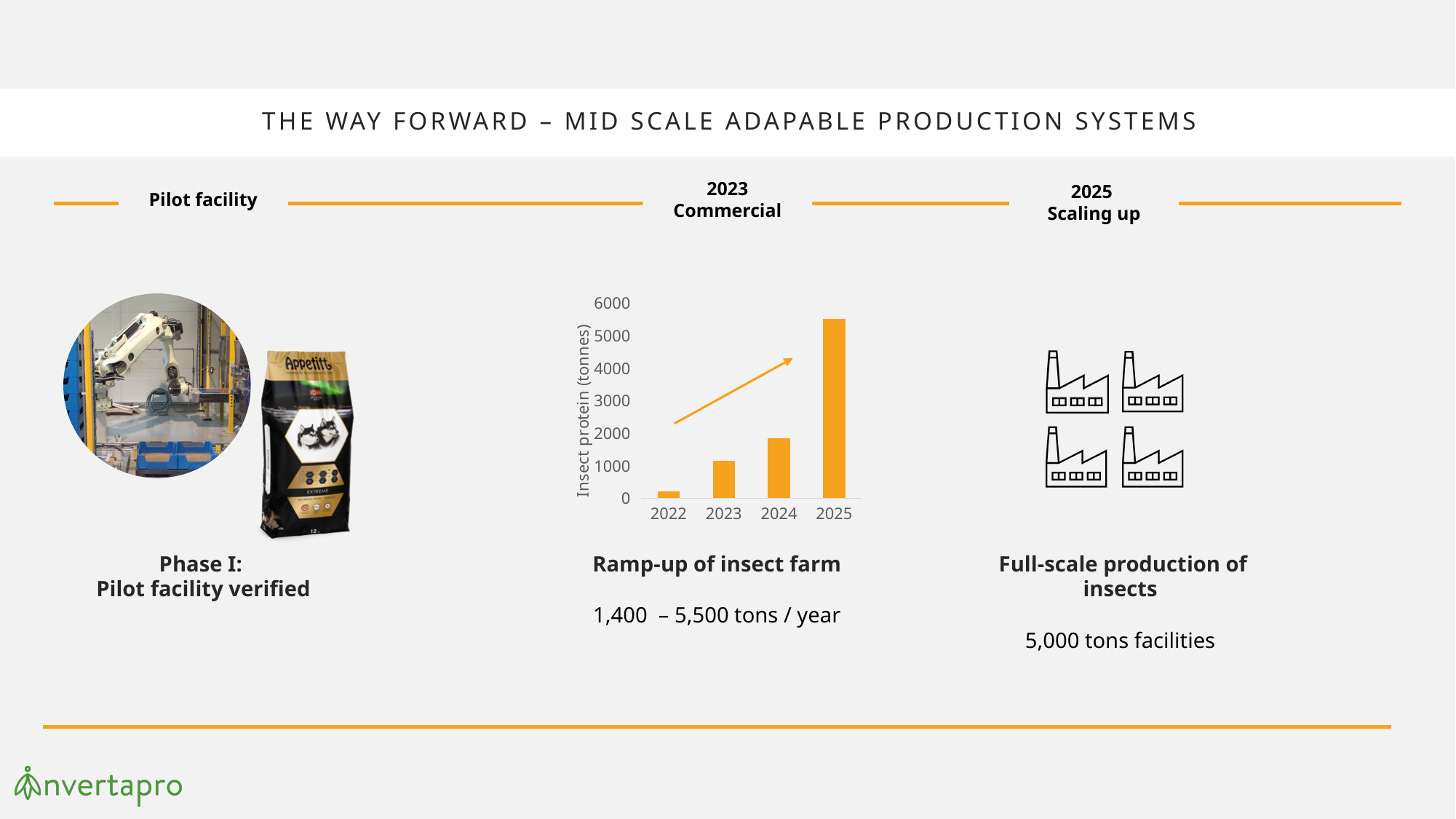
Which is larger in the chart, the value for 2023 or the value for 2024? 2024 Which year has the highest bar in the chart? 2025 Is the value for 2025 greater or less than 5000? greater Is the value for 2023 greater or less than 2000? less Do the values in the chart rise or fall from 2022 to 2025? rise What is the label of the vertical axis of the chart? Insect protein (tonnes) Which year has the lowest bar in the chart? 2022 Is the value for 2022 greater or less than 1000? less What kind of chart is shown on the slide? bar chart How many years are shown on the x axis of the chart? 4